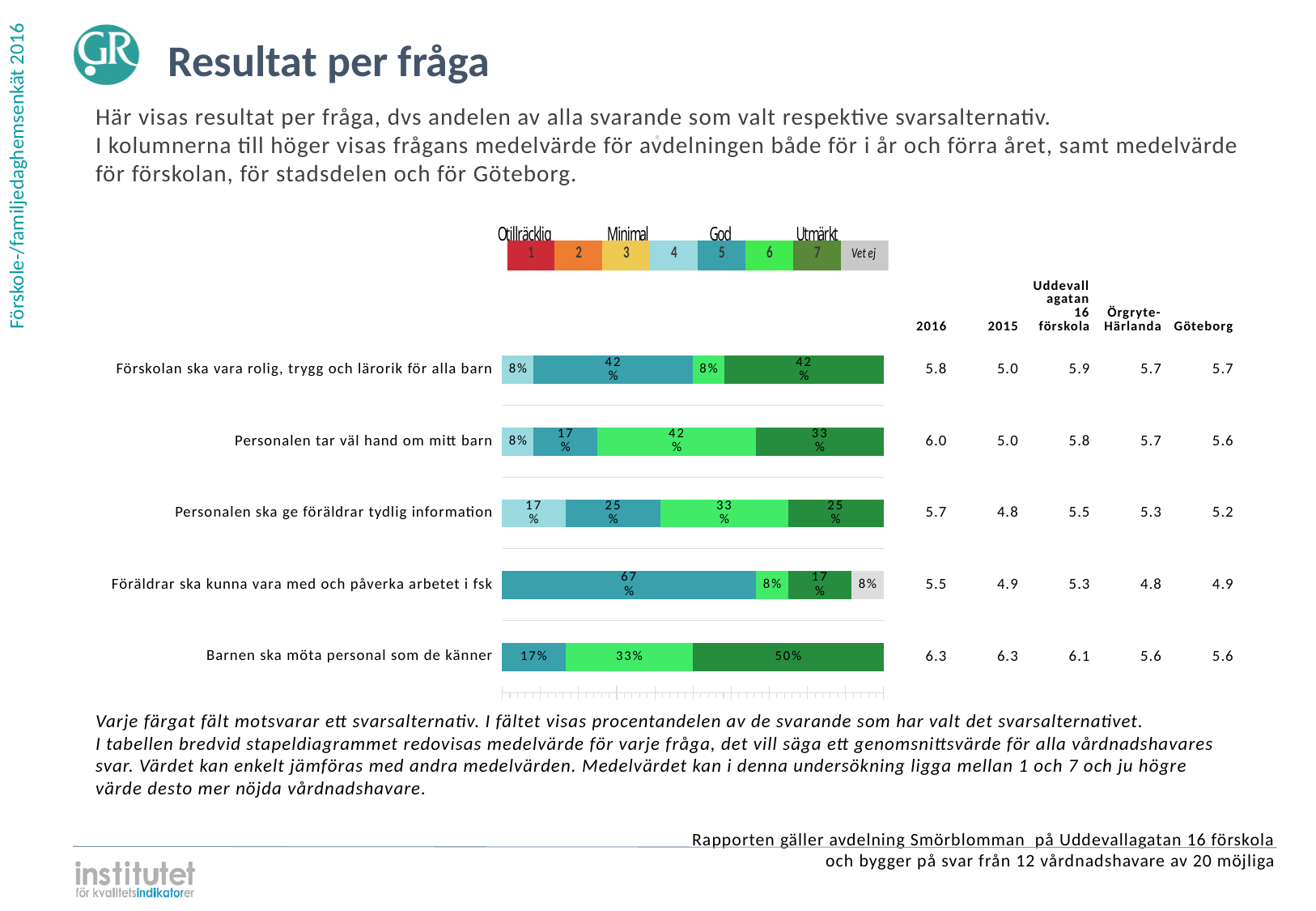
Which question has the smallest share of respondents choosing answer 7 (dark green)? Föräldrar ska kunna vara med och påverka arbetet i fsk What is the difference between the answer 7 share for 'Förskolan ska vara rolig, trygg och lärorik för alla barn' (42%) and for 'Personalen ska ge föräldrar tydlig information' (25%)? 17% What percentage of respondents chose answer 6 (light green) for 'Personalen tar väl hand om mitt barn'? 42% What percentage of respondents chose answer 5 (teal) for 'Föräldrar ska kunna vara med och påverka arbetet i fsk'? 67% Which is larger: the answer 6 share for 'Personalen tar väl hand om mitt barn' or the answer 6 share for 'Barnen ska möta personal som de känner'? Personalen tar väl hand om mitt barn What percentage of respondents chose answer 7 (dark green) for 'Barnen ska möta personal som de känner'? 50% What is the combined share of answers 6 and 7 for 'Personalen ska ge föräldrar tydlig information'? 58% How many answer alternatives does the legend above the chart list? 8 Which question has a 'Vet ej' (grey) segment in its bar? Föräldrar ska kunna vara med och påverka arbetet i fsk How many questions (categories) are plotted in the bar chart? 5 Which question has the largest share of respondents choosing answer 7 (dark green)? Barnen ska möta personal som de känner What kind of chart is shown on the slide? stacked bar chart